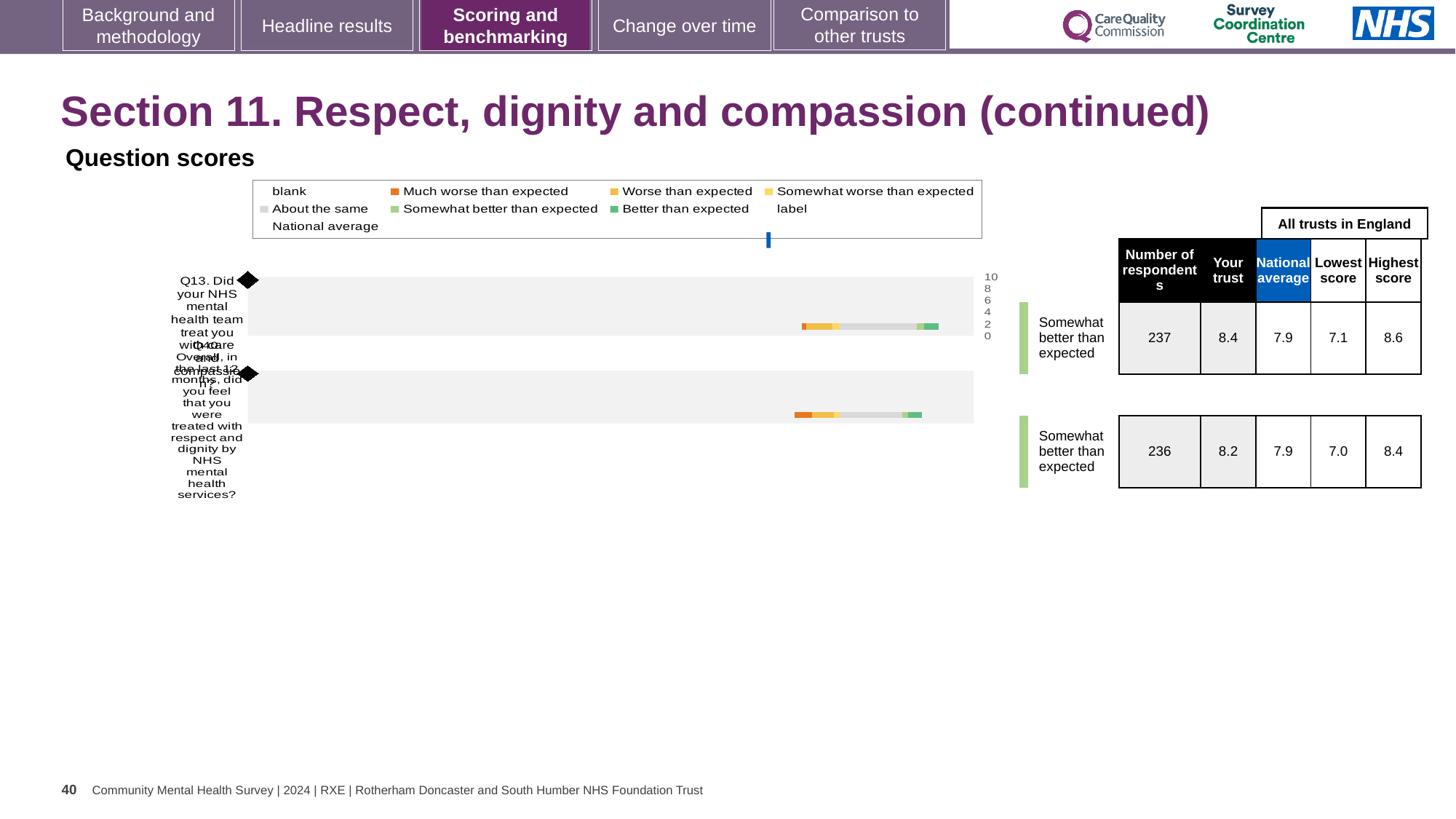
What is the lowest score among all trusts in England for Q14? 7.0 What is the difference between the trust's score and the national average for Q13? 0.5 How many questions (categories) are plotted in the question scores chart? 2 What kind of chart is used to show the question scores on this slide? bar chart What is the trust's score for Q13 (care and compassion) shown in the table next to the chart? 8.4 Which question has the higher trust score, Q13 or Q14? Q13 What is the difference between the highest and lowest scores across all trusts for Q14? 1.4 What is the trust's score for Q14 (respect and dignity) shown in the table next to the chart? 8.2 How many respondents answered Q14? 236 What benchmark category is shown for Q13 in the question scores chart? Somewhat better than expected What is the national average score for Q13? 7.9 What is the highest score among all trusts in England for Q13? 8.6